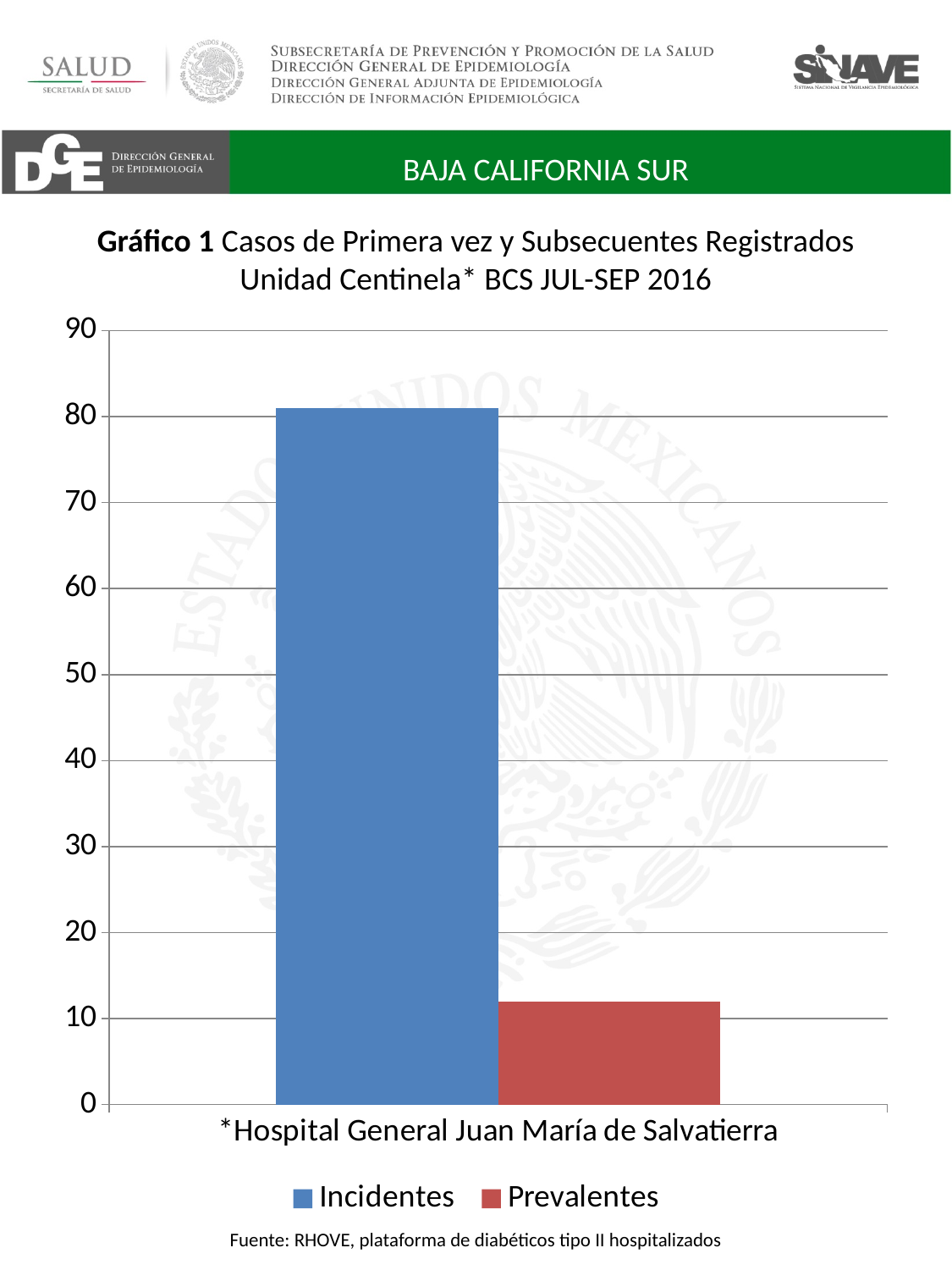
What is the category label on the x axis? *Hospital General Juan María de Salvatierra Is the value for Prevalentes greater or less than 20? less What colour is the bar for Prevalentes? red Which series has the higher value, Incidentes or Prevalentes? Incidentes How many series does the legend list? 2 Which series has the highest value? Incidentes Which series has the lowest value? Prevalentes How many categories are shown on the x axis? 1 What kind of chart is shown on the slide? bar chart Is the value for Prevalentes greater or less than 10? greater Is the value for Incidentes greater or less than 90? less